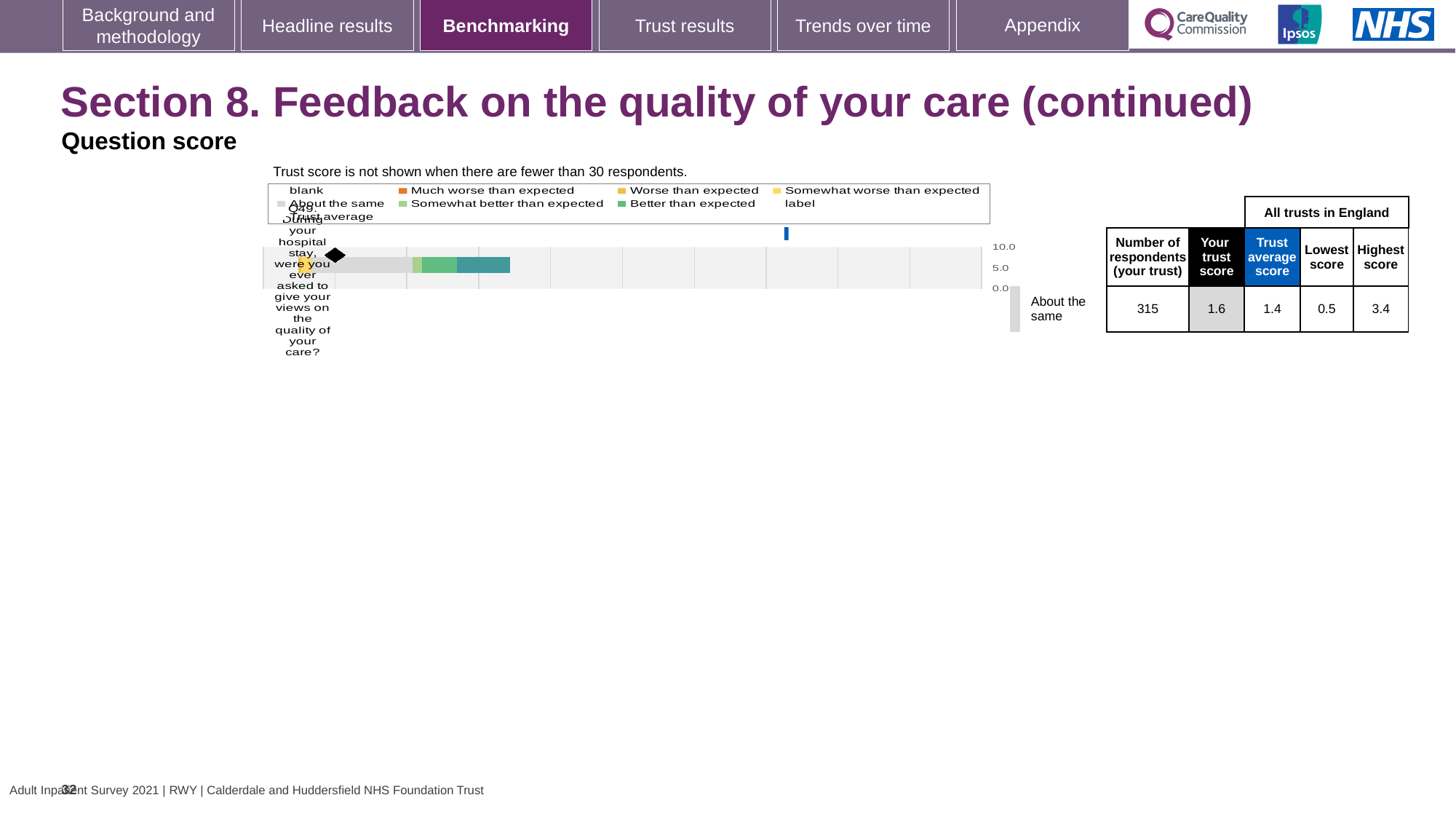
In the table beside the chart, what is the trust average score for Q49? 1.4 Which is larger for Q49, your trust score or the trust average score? Your trust score What colour does the legend use for "Much worse than expected"? orange In the table beside the chart, what is the number of respondents for your trust for Q49? 315 In the table beside the chart, what is the highest score among all trusts in England for Q49? 3.4 How many survey questions are plotted as categories in the chart? 1 Which question is plotted in the chart? Q49 In the table beside the chart, what is your trust score for Q49? 1.6 What is the difference between the highest and lowest scores among all trusts in England for Q49? 2.9 What kind of chart is shown on the slide? bar chart In the table beside the chart, what is the lowest score among all trusts in England for Q49? 0.5 What is the difference between your trust score and the trust average score for Q49? 0.2